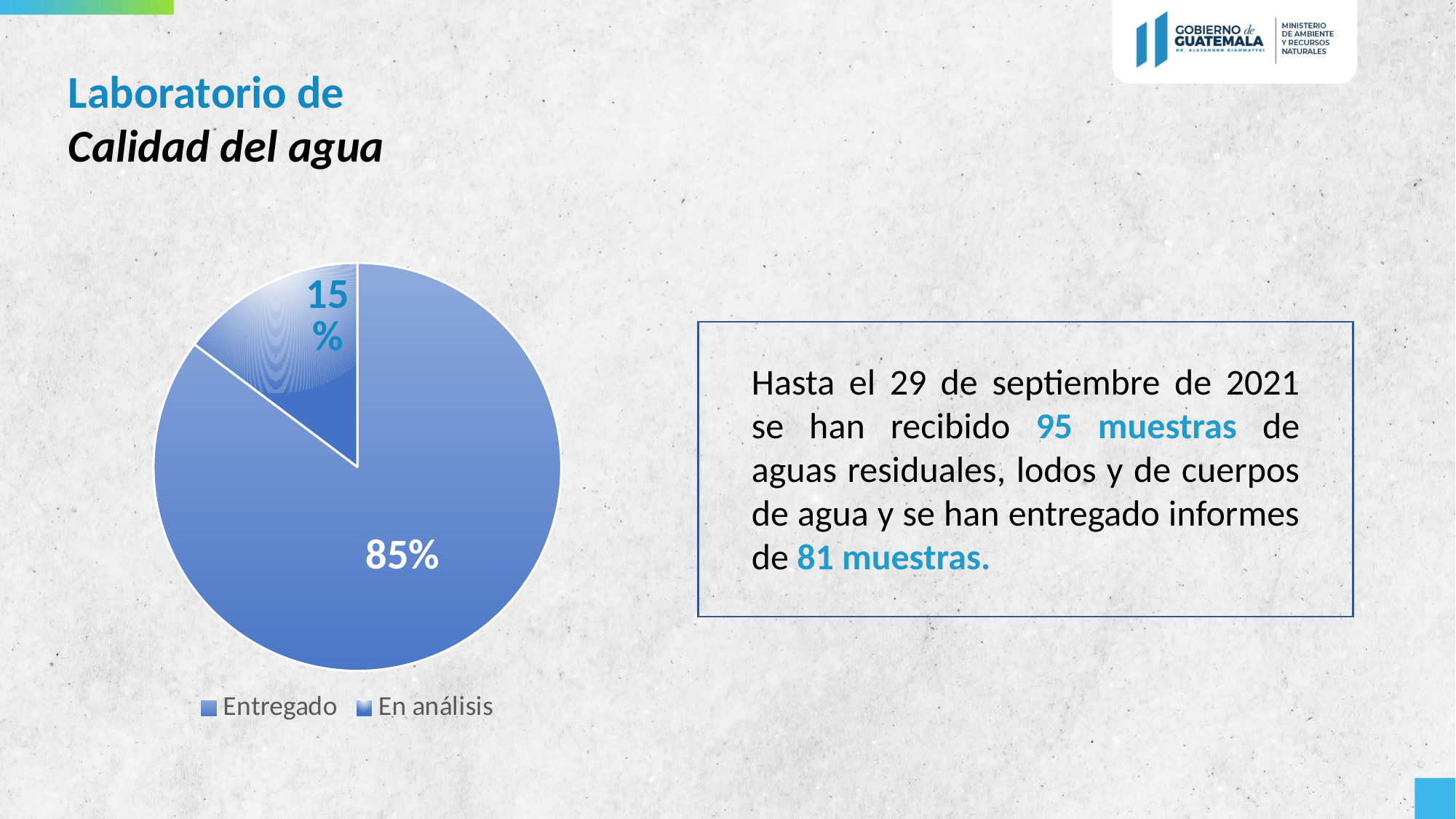
What share of the pie does the En análisis slice represent? 15% Which is larger, the Entregado slice or the En análisis slice? Entregado What is the difference in percentage points between the Entregado and En análisis slices? 70 What kind of chart is shown on the slide? pie chart What share of the pie does the Entregado slice represent? 85% How many entries does the legend list? 2 Where is the legend positioned relative to the pie chart? below the chart What are the two legend entries of the pie chart? Entregado, En análisis How many slices does the pie chart have? 2 Which slice of the pie is the largest? Entregado Which slice of the pie is the smallest? En análisis